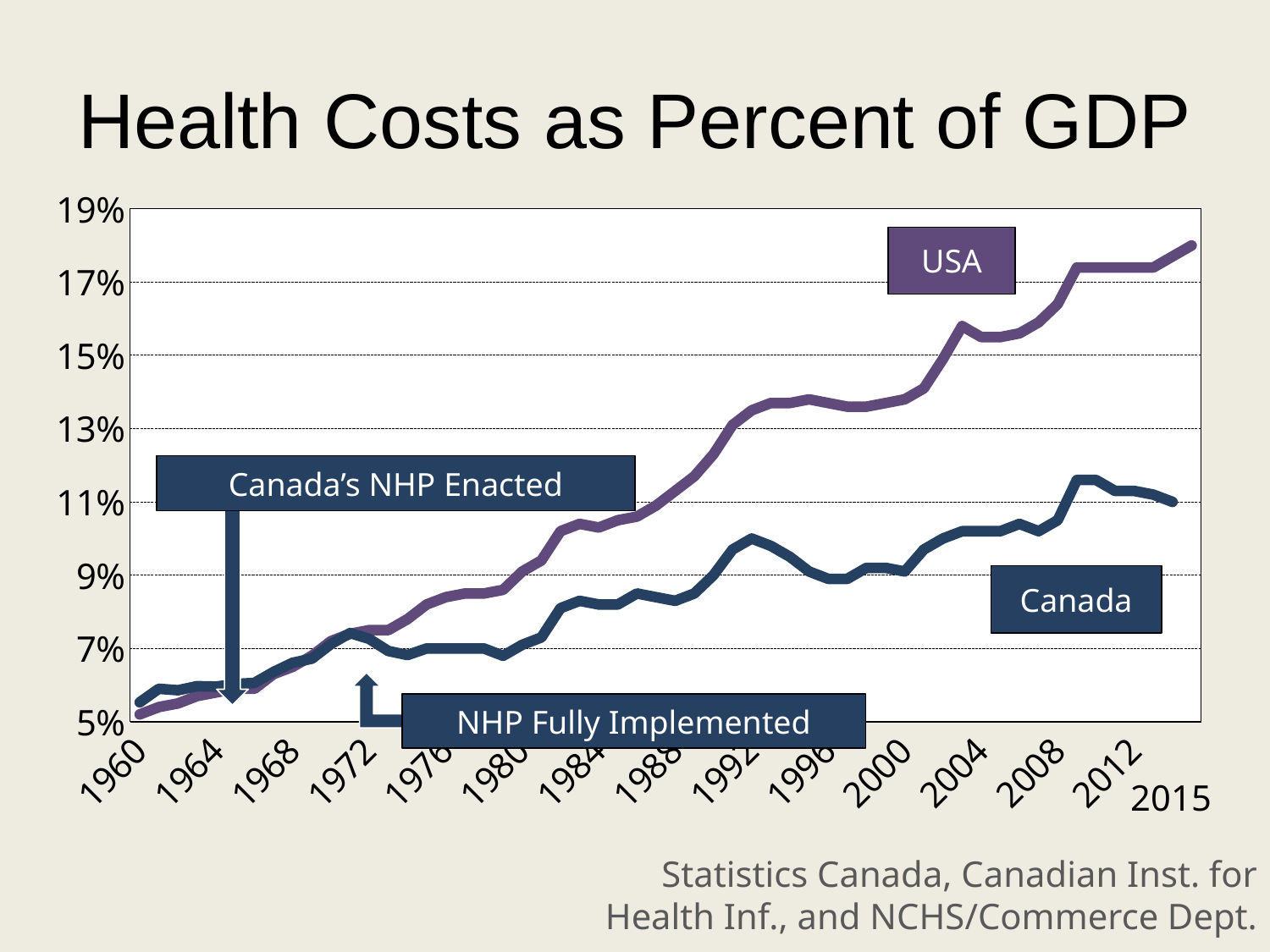
Is the value for Canada in 1976 greater or less than 9%? less In 2015, which series has the higher value, USA or Canada? USA Is the value for the USA in 2015 greater or less than 17%? greater Is the value for the USA in 2000 greater or less than 13%? greater What kind of chart is shown on the slide? line chart Which series has the higher value in 2008, USA or Canada? USA Which two countries are plotted on the chart? USA and Canada Does the USA series generally rise or fall from 1960 to 2015? rise What is the title of the chart? Health Costs as Percent of GDP How many series are plotted on the chart? 2